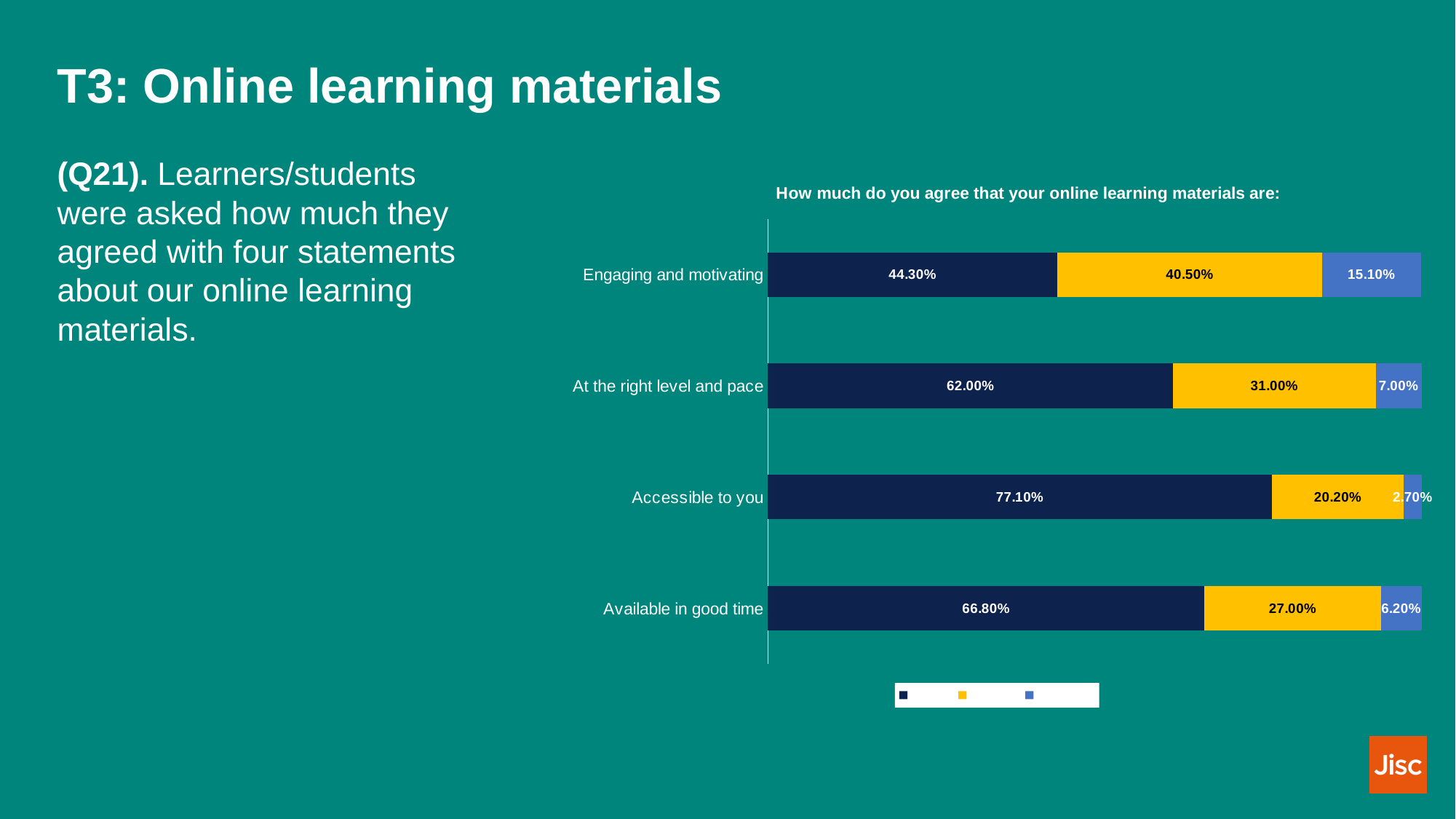
What is the difference between the dark navy values for "Accessible to you" and "Engaging and motivating"? 32.80% What is the value of the dark navy segment for "Available in good time"? 66.80% What is the total of the stacked bar for "At the right level and pace"? 100.00% What is the value of the yellow segment for "Engaging and motivating"? 40.50% Which category has the highest value in the dark navy segment? Accessible to you What is the value of the light blue segment for "At the right level and pace"? 7.00% How many categories are shown on the chart? 4 What is the value of the dark navy segment for "Accessible to you"? 77.10% Which is larger: the yellow segment for "At the right level and pace" or the yellow segment for "Available in good time"? At the right level and pace How many series does the legend list? 3 What kind of chart is shown on the slide? Stacked bar chart Which category has the lowest value in the light blue segment? Accessible to you